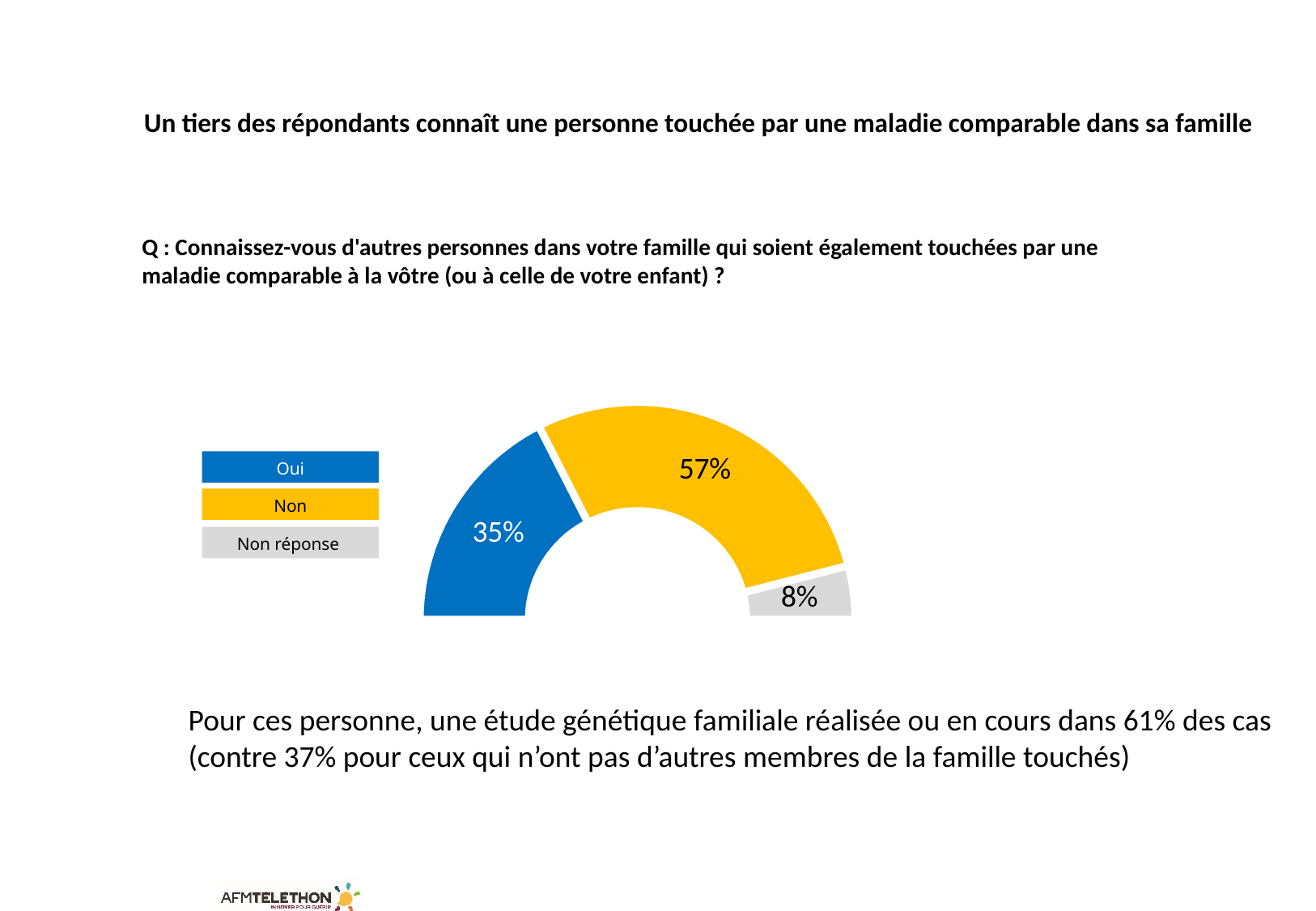
What kind of chart is shown on the slide? Doughnut (semi-circle) chart How many response categories are shown in the chart? 3 Which is larger, the share for "Oui" or the share for "Non réponse"? Oui What percentage of respondents answered "Non"? 57% Which response category has the largest share? Non What colour represents the "Non" category? Yellow What percentage of respondents answered "Oui"? 35% Which response category has the smallest share? Non réponse What is the combined share of "Oui" and "Non"? 92% What percentage of respondents gave "Non réponse"? 8% What is the difference in percentage points between "Non" and "Oui"? 22 What colour represents the "Oui" category? Blue